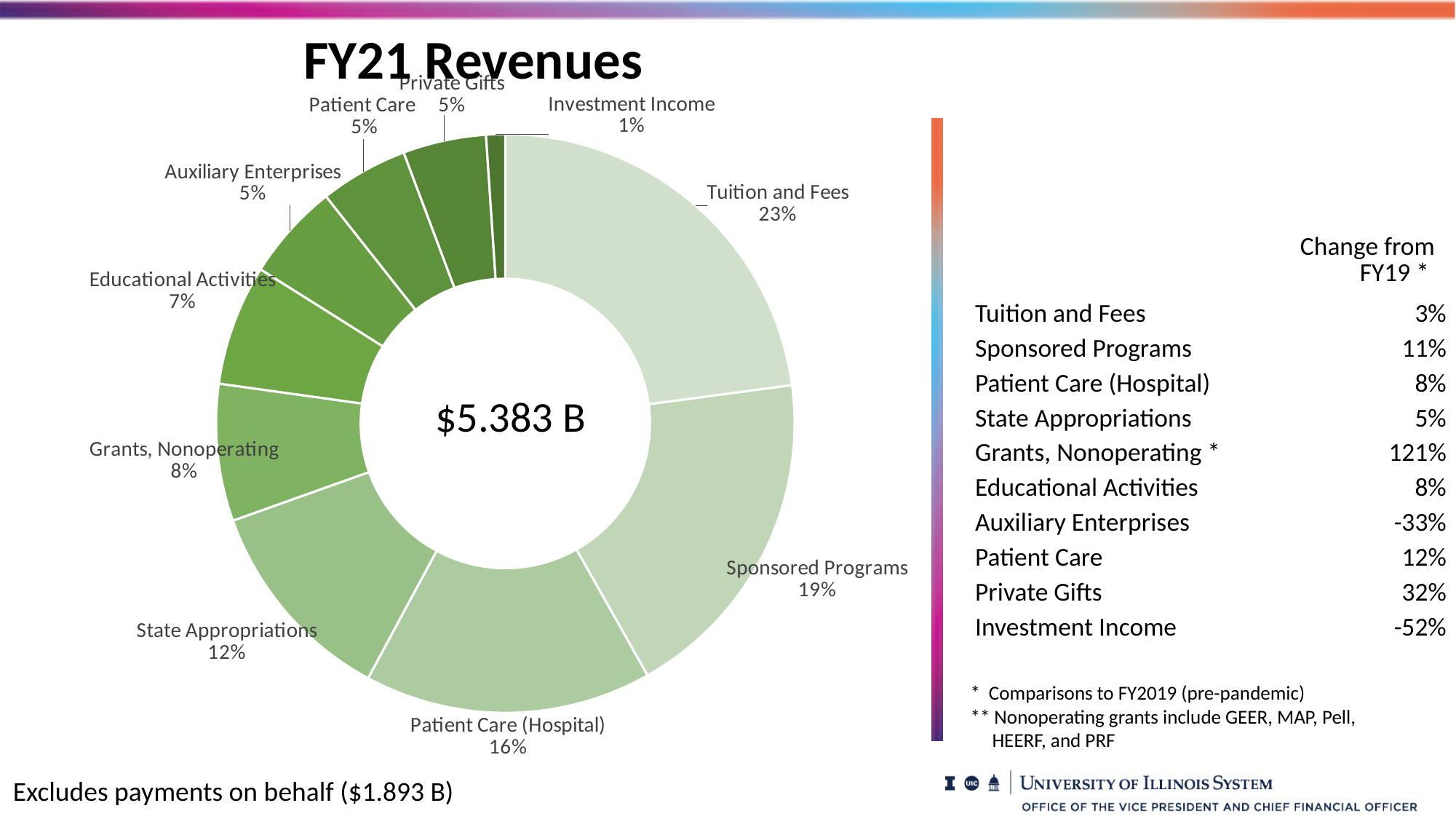
What share of FY21 revenues comes from Sponsored Programs? 19% Which has a larger share of FY21 revenues, Grants, Nonoperating or State Appropriations? State Appropriations Which revenue category has the largest share in the FY21 Revenues chart? Tuition and Fees What is the title of the chart on the slide? FY21 Revenues How many revenue categories are shown in the FY21 Revenues chart? 10 What share of FY21 revenues comes from State Appropriations? 12% What total amount is shown in the center of the FY21 Revenues chart? $5.383 B Which revenue category has the smallest share in the FY21 Revenues chart? Investment Income What share of FY21 revenues comes from Tuition and Fees? 23% What kind of chart is shown on the slide? Pie chart (donut) What is the difference in share between Tuition and Fees and Patient Care (Hospital)? 7% What share of FY21 revenues comes from Educational Activities? 7%